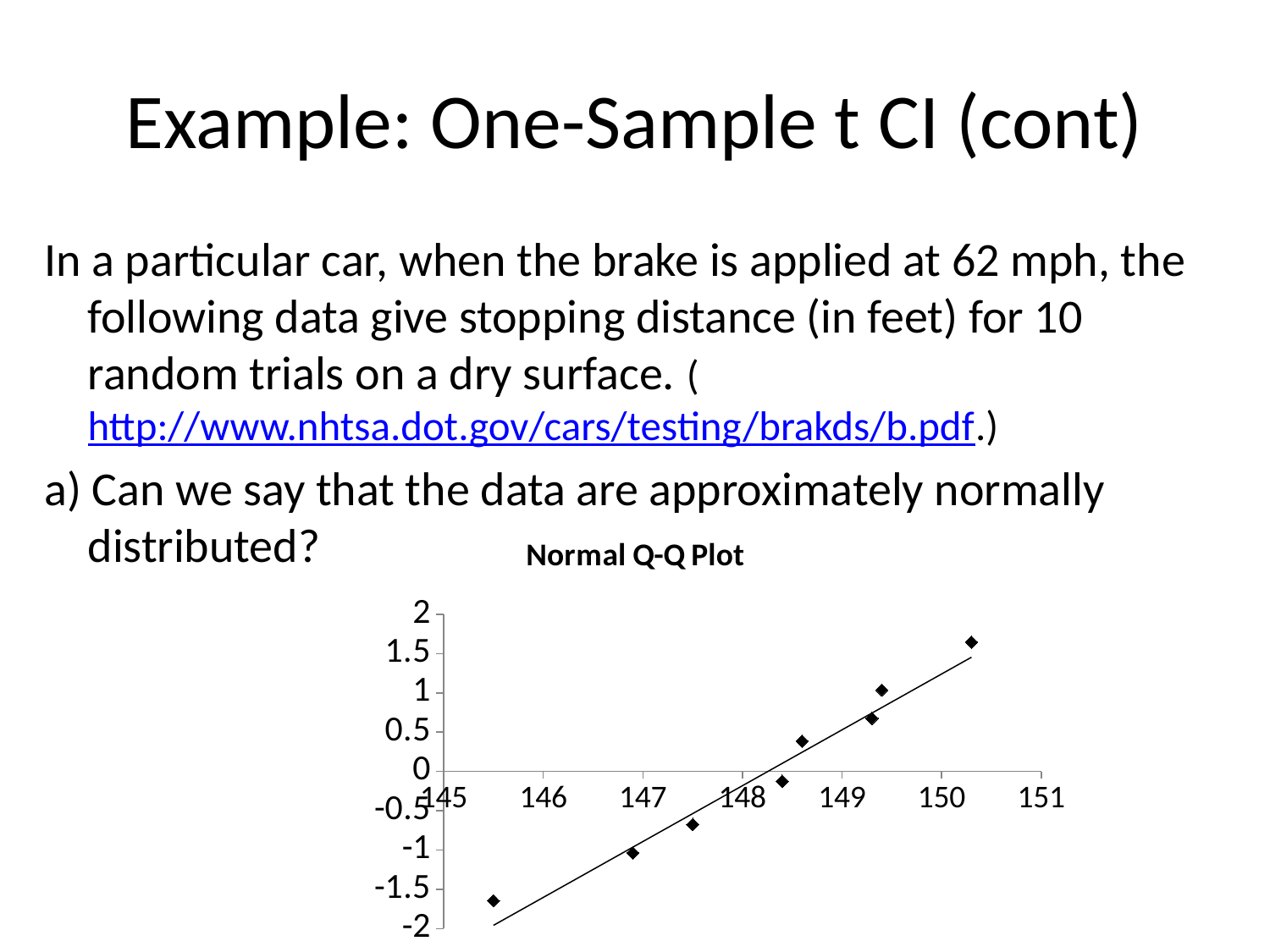
In the Normal Q-Q Plot, is the x value of the rightmost point greater or less than 150? greater In the Normal Q-Q Plot, is the y value of the leftmost point greater or less than -1.5? less What kind of chart is shown on the slide? scatter plot In the Normal Q-Q Plot, is the x value of the leftmost point greater or less than 146? less In the Normal Q-Q Plot, which point has the highest y value: the leftmost point or the rightmost point? the rightmost point What is the title of the chart on the slide? Normal Q-Q Plot What is the highest value shown on the y-axis of the Normal Q-Q Plot? 2 Do the plotted points in the Normal Q-Q Plot rise or fall as the x-axis value increases? rise